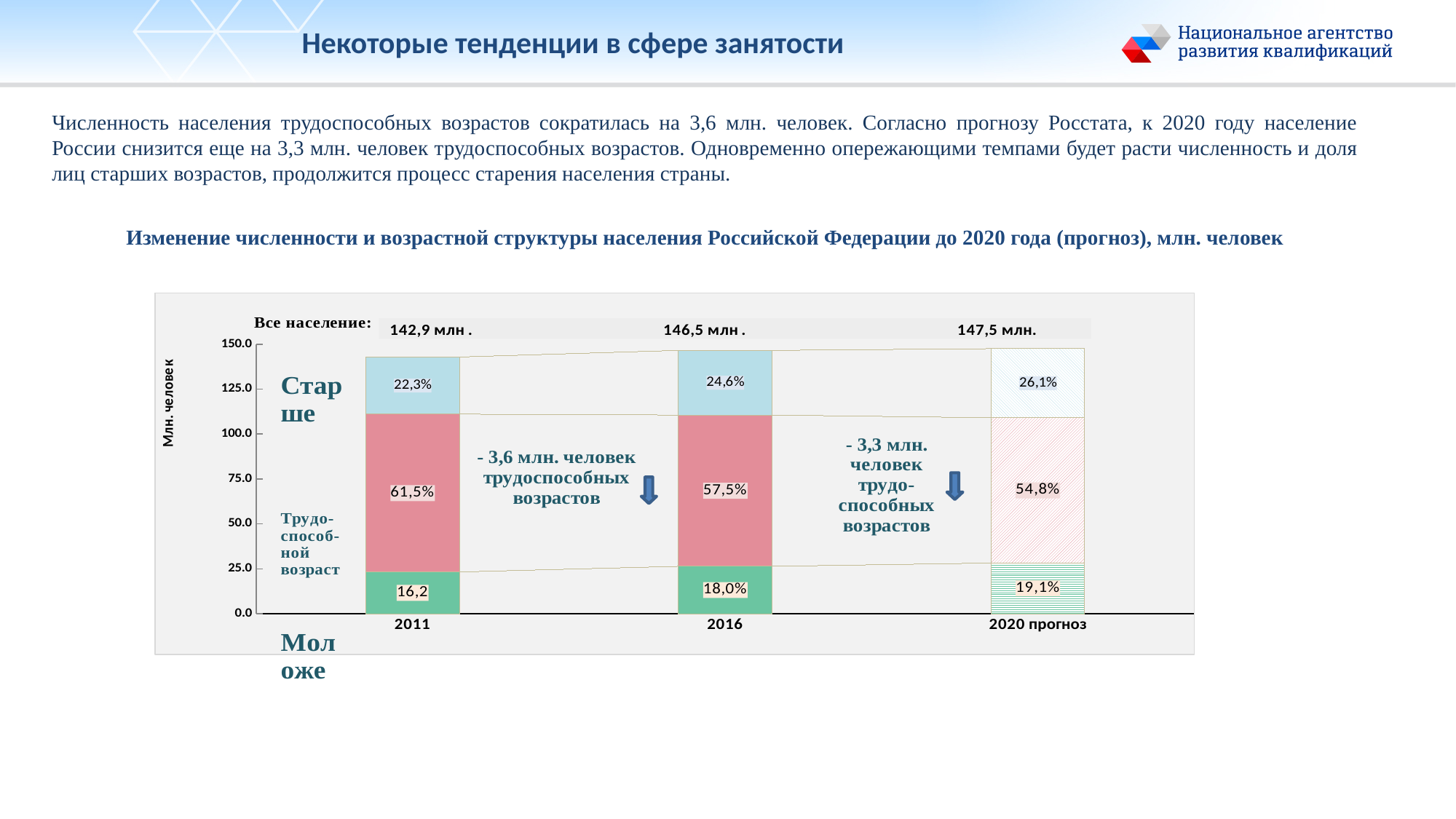
What total population (Все население) is shown above the 2016 bar? 146,5 млн. By how many percentage points does the working-age share fall from 2011 (61,5%) to 2016 (57,5%)? 4,0 Which year has the lowest total population (Все население) shown above the bars? 2011 How many years (categories) are shown on the x axis? 3 What share of the population is shown for the working-age (Трудоспособный возраст) segment in 2011? 61,5% Is the total height of the 2011 bar greater or less than 125 on the y axis? greater What is the label on the older-age (Старше) segment for 2016? 24,6% Does the working-age (Трудоспособный возраст) share rise or fall from 2011 to 2020 прогноз? fall What kind of chart is this? stacked bar chart Which is larger: the older-age (Старше) share in 2011 or in 2020 прогноз? 2020 прогноз What is the label on the younger (Моложе) segment for 2020 прогноз? 19,1% Which year has the highest total population (Все население) shown above the bars? 2020 прогноз